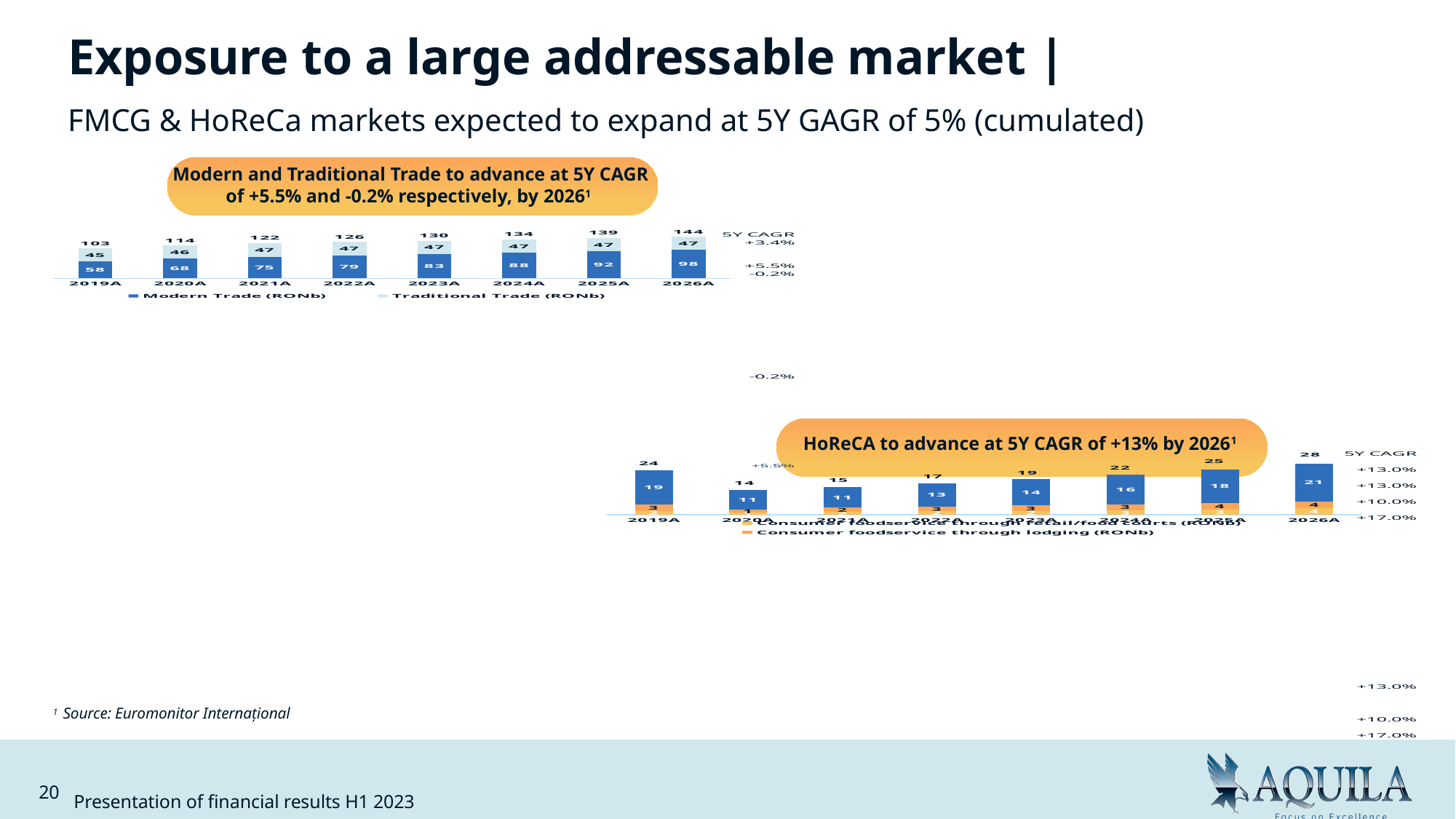
In the Modern and Traditional Trade chart, how many years are shown on the x axis? 8 In the HoReCa chart, which year has the lowest total? 2020A What kind of chart is the HoReCa chart on the lower right of the slide? stacked bar chart In the Modern and Traditional Trade chart, what is the Modern Trade value for 2019A? 58 In the Modern and Traditional Trade chart, how many series does the legend list? 2 In the HoReCa chart, what is the total of the stacked bar for 2026A? 28 In the Modern and Traditional Trade chart, what is the total of the stacked bar for 2023A? 130 In the Modern and Traditional Trade chart, what is the difference between the Modern Trade values for 2026A and 2019A? 40 In the Modern and Traditional Trade chart, which year has the lowest Modern Trade value? 2019A In the Modern and Traditional Trade chart, do the Modern Trade values rise or fall from 2019A to 2026A? rise In the Modern and Traditional Trade chart, which year has the highest total? 2026A In the Modern and Traditional Trade chart, what is the Traditional Trade value for 2026A? 47